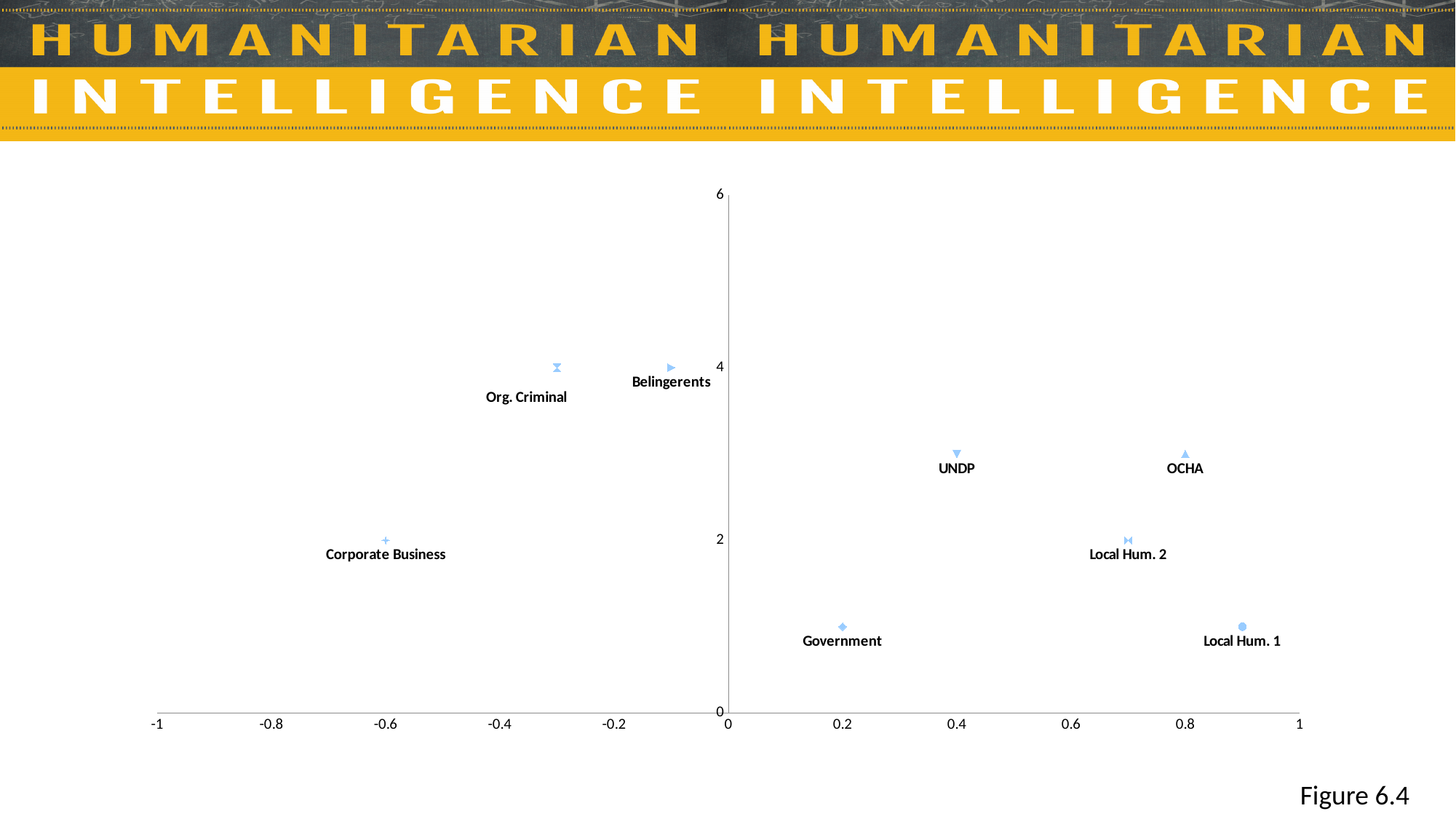
Which point has the lowest horizontal-axis value? Corporate Business Is the vertical-axis value for Local Hum. 1 greater or less than 2? less What type of chart is shown on the slide? scatter chart What is the difference between the vertical-axis values of Org. Criminal and Corporate Business? 2 What is the horizontal-axis value of the OCHA point? 0.8 What is the horizontal-axis value of the Corporate Business point? -0.6 How many labeled data points are plotted on the chart? 8 What is the vertical-axis value of the Corporate Business point? 2 What is the vertical-axis value of the Org. Criminal point? 4 Is the vertical-axis value for UNDP greater or less than 2? greater What is the horizontal-axis value of the Government point? 0.2 Which point has the highest horizontal-axis value? Local Hum. 1